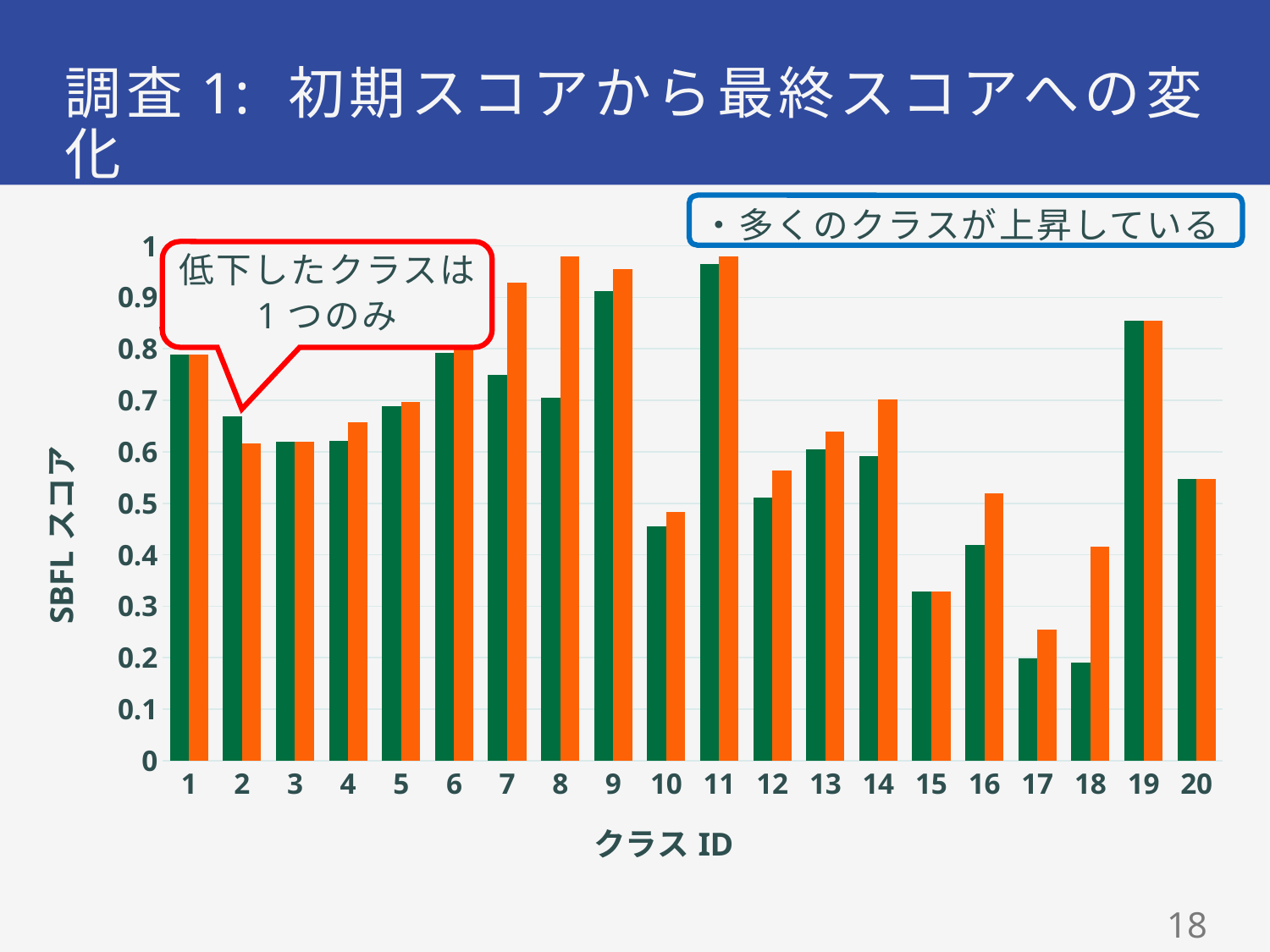
Is the green bar for class 10 greater or less than 0.5? less Is the green bar for class 17 greater or less than 0.3? less Which class ID has the shortest orange bar? 17 For class 2, which bar is taller, the green one or the orange one? green What is the title of the y axis? SBFL スコア How many class IDs (categories) are shown on the x axis? 20 What kind of chart is shown on the slide? bar chart Is the orange bar for class 14 greater or less than 0.6? greater Which class ID has the tallest green bar? 11 What is the title of the x axis? クラス ID For class 16, which bar is taller, the green one or the orange one? orange